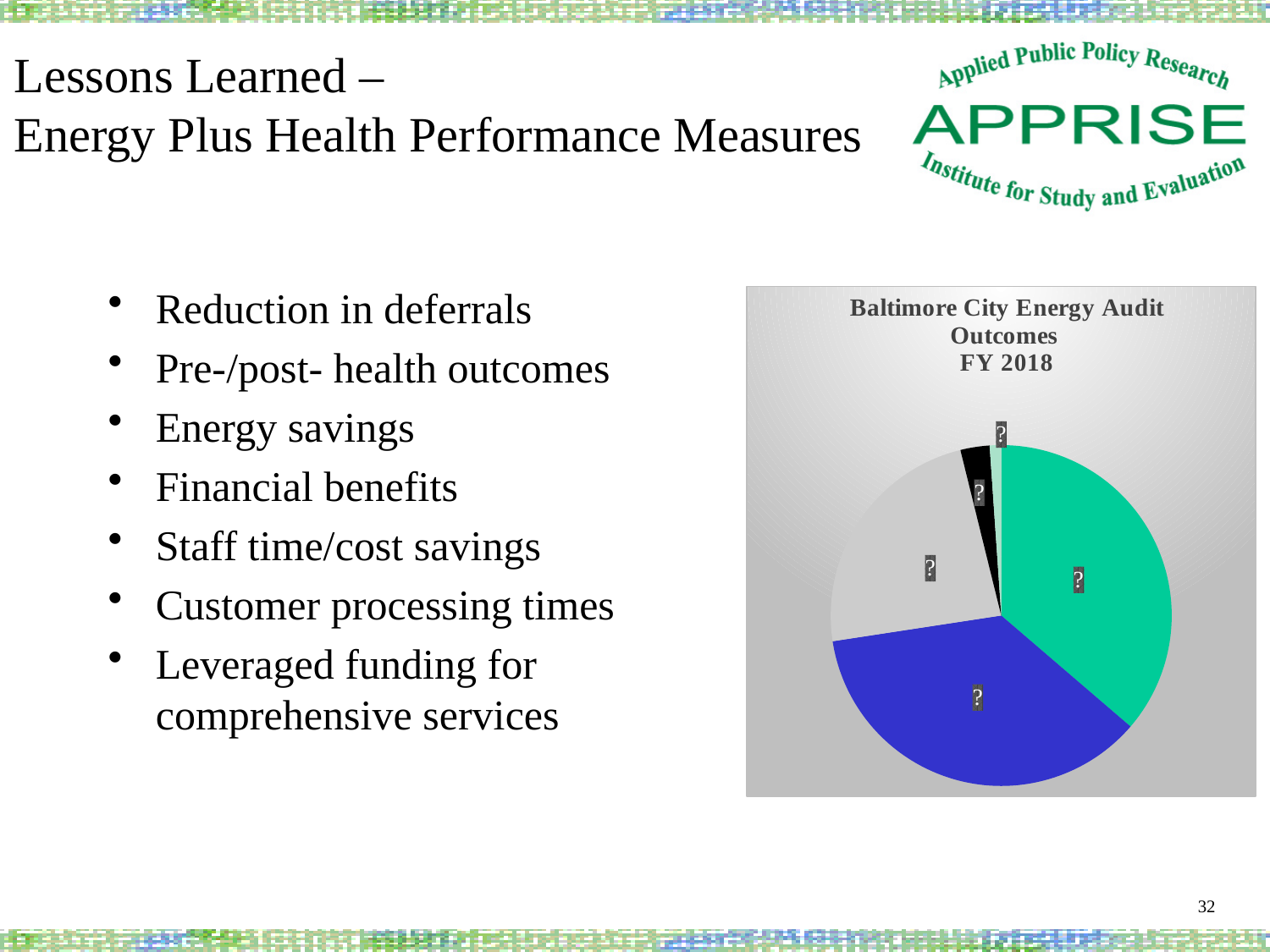
What kind of chart is shown on the slide? pie chart How many slices does the pie chart have? 5 Which fiscal year does the pie chart cover? FY 2018 In the pie chart, which is larger, the green slice or the black slice? the green slice In the pie chart, which is larger, the blue slice or the light gray slice? the blue slice In the pie chart, which is larger, the blue slice or the black slice? the blue slice What is the title of the chart on the slide? Baltimore City Energy Audit Outcomes FY 2018